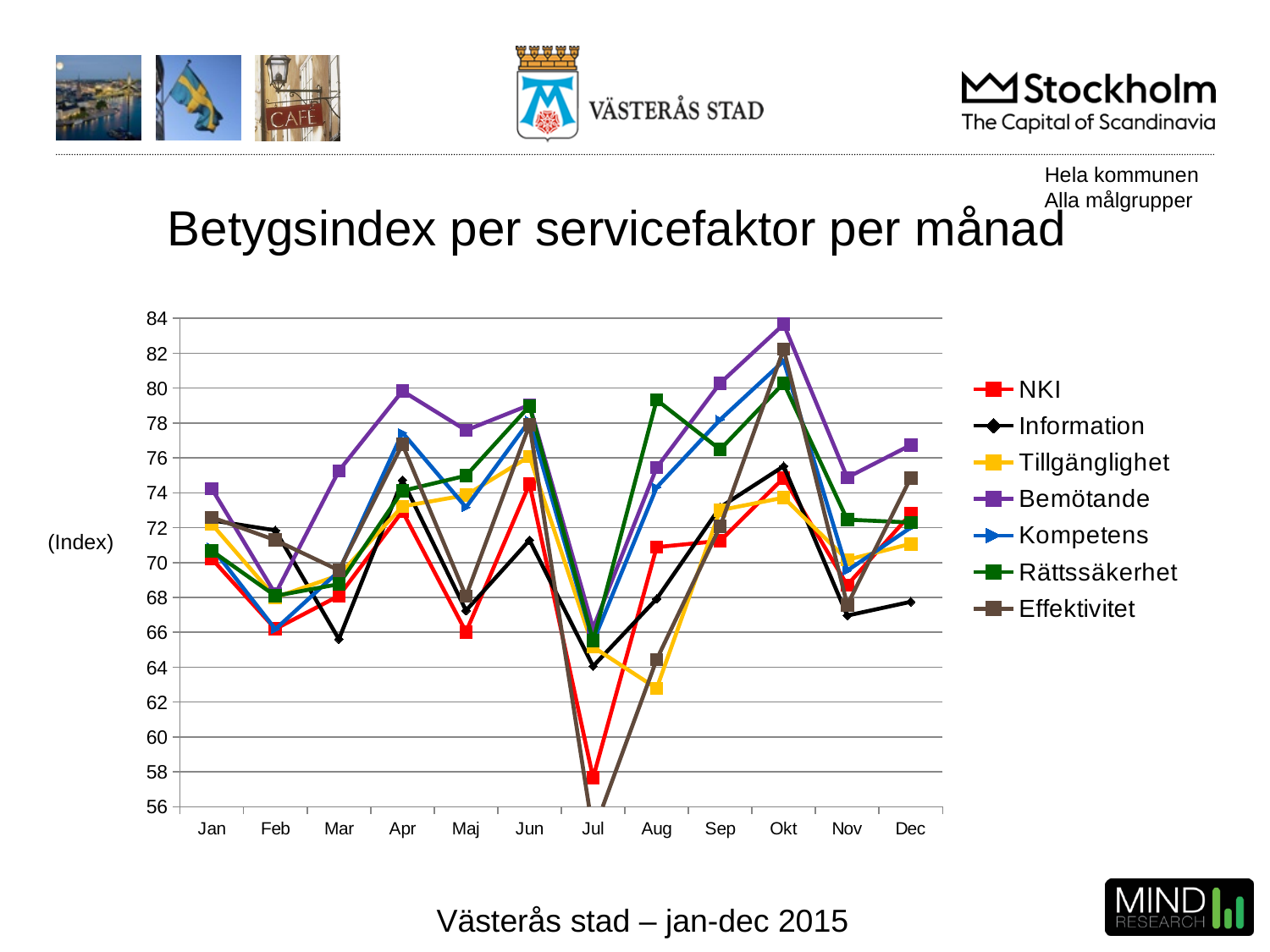
Which series has the highest value in Okt? Bemötande What is the title of the chart? Betygsindex per servicefaktor per månad What kind of chart is shown on the slide? line chart Does the NKI series rise or fall from Jul to Okt? rise In Aug, which is larger: Rättssäkerhet or Tillgänglighet? Rättssäkerhet Is the value for Bemötande in Okt greater or less than 82? greater Is the value for NKI in Jul greater or less than 60? less In which month does Bemötande reach its highest value? Okt How many series does the legend list? 7 How many months are shown on the x axis? 12 Is the value for Tillgänglighet in Aug greater or less than 64? less In which month does NKI reach its lowest value? Jul